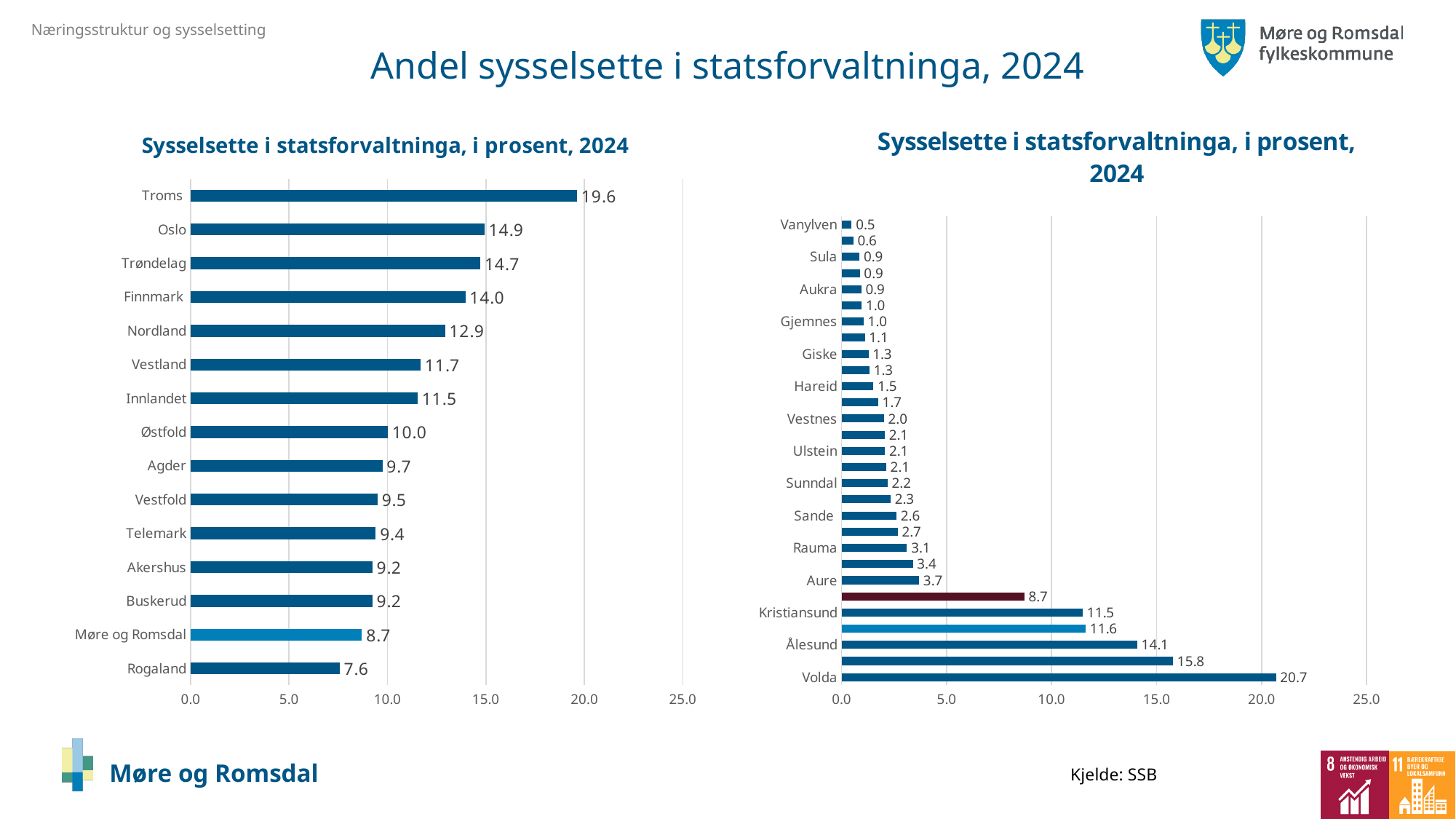
On the left chart, what is the difference between Oslo and Rogaland? 7.3 On the right chart, which category has the highest value? Volda On the left chart, which is larger, Nordland or Vestland? Nordland On the right chart, is the value for Vanylven greater or less than 5.0? less On the right chart, what is the value for Volda? 20.7 On the left chart, what is the value for Troms? 19.6 On the left chart, which category has the lowest value? Rogaland What kind of chart is the left chart? Bar chart On the right chart, what is the value for Kristiansund? 11.5 How many categories are shown on the left chart? 15 On the left chart, what is the value for Møre og Romsdal? 8.7 On the right chart, what is the difference between Ålesund and Aure? 10.4